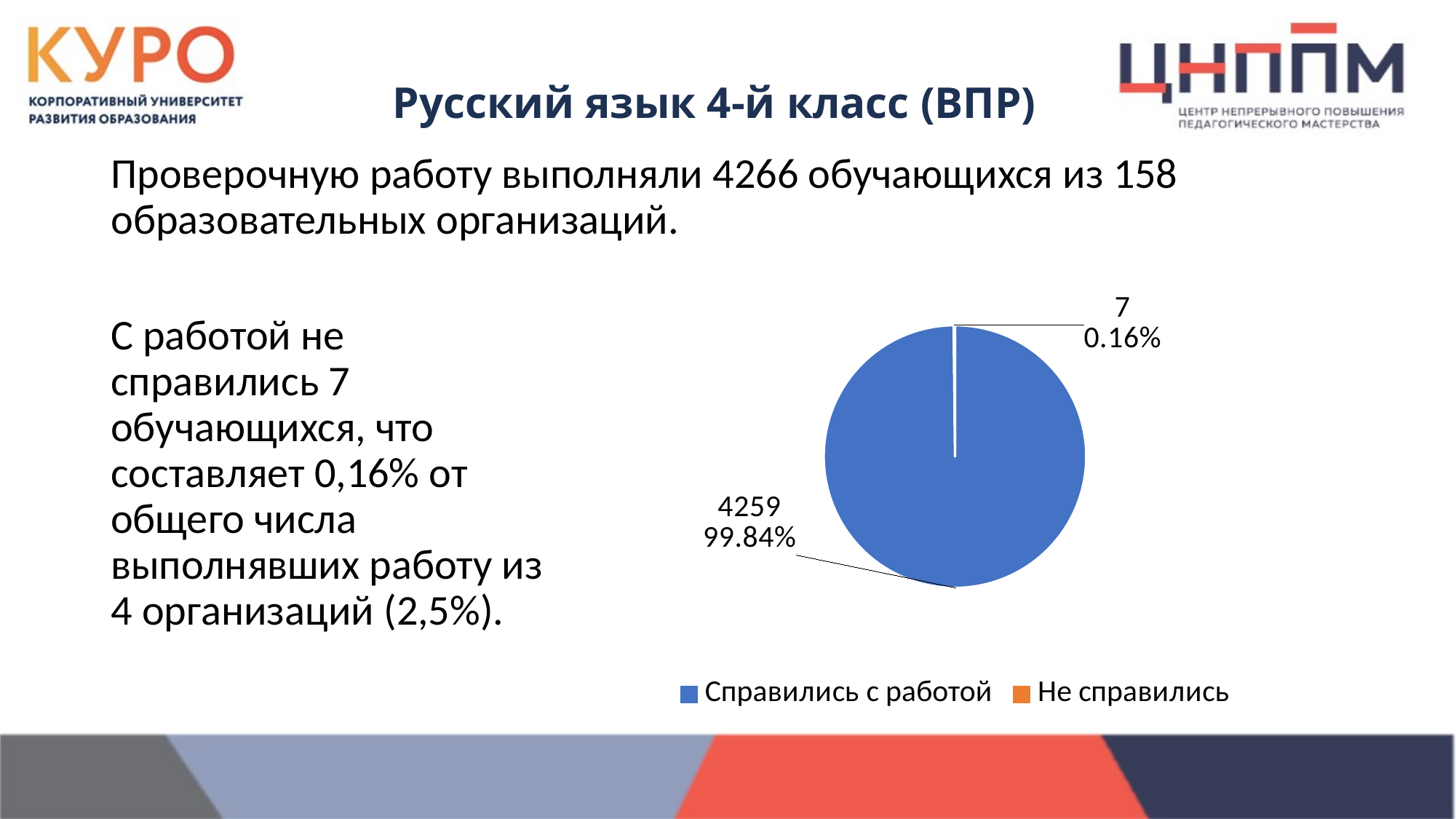
How many entries does the legend of the pie chart list? 2 Which slice of the pie chart is the largest? Справились с работой Which slice of the pie chart is the smallest? Не справились What kind of chart is shown on the slide? pie chart What is the difference between the number of students who passed and the number who did not pass? 4252 What share of the pie does the 'Не справились' slice represent? 0.16% How many students are in the 'Не справились' slice of the pie chart? 7 What share of the pie does the 'Справились с работой' slice represent? 99.84% How many students are in the 'Справились с работой' slice of the pie chart? 4259 What colour is the 'Справились с работой' slice in the pie chart? blue What is the total number of students represented in the pie chart? 4266 Which is larger: the 'Справились с работой' slice or the 'Не справились' slice? Справились с работой